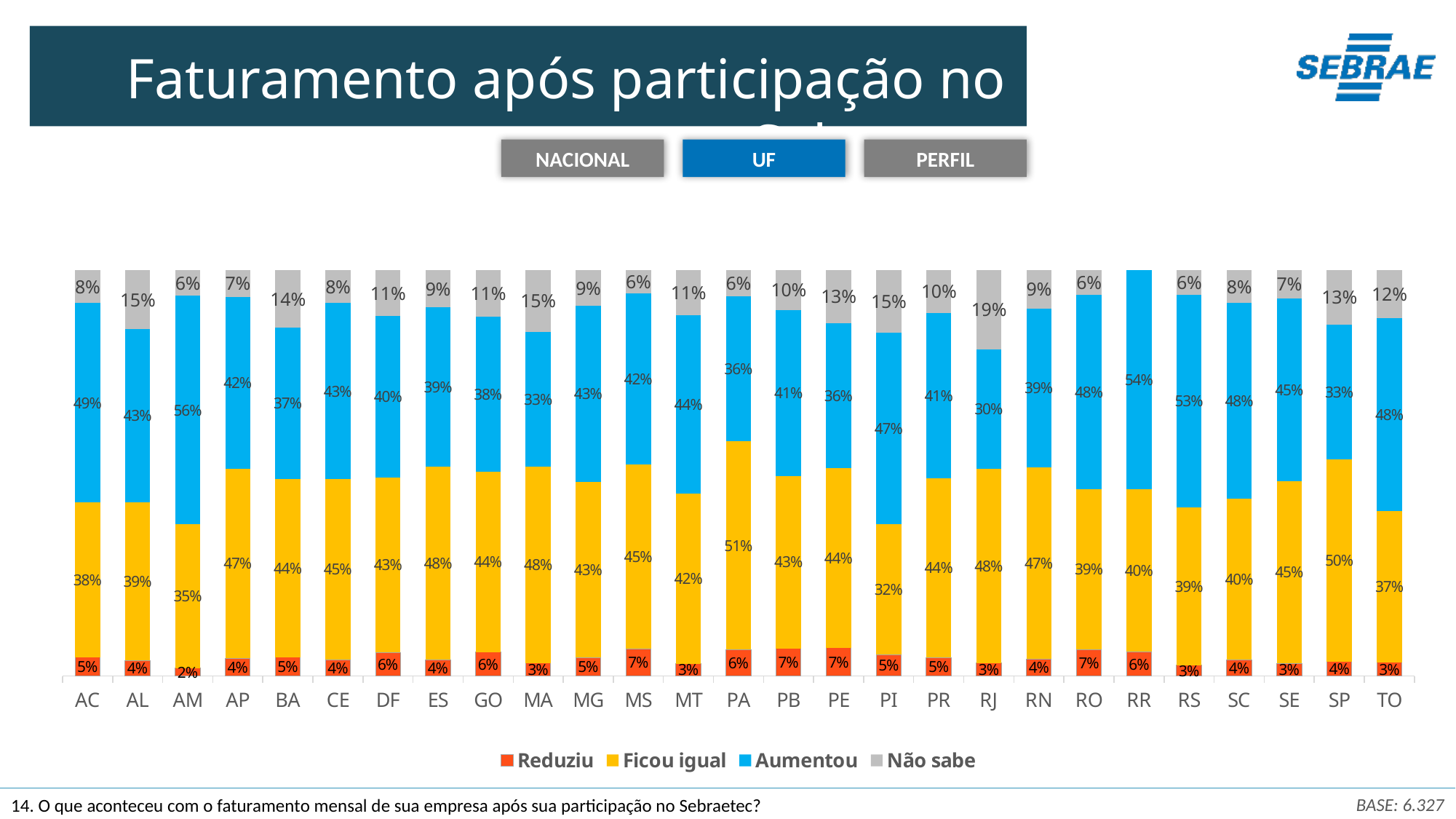
Which legend entry is shown in red? Reduziu Which is larger, the 'Ficou igual' value for SP or for TO? SP What is the difference between the 'Aumentou' values for AM and RJ? 26% Which UF has the lowest 'Reduziu' value? AM Which UF has the highest 'Não sabe' value? RJ What is the 'Ficou igual' value for PA? 51% What is the 'Aumentou' value for AM? 56% What type of chart is shown on the slide? Stacked bar chart How many UF categories are shown on the x axis? 27 What is the 'Não sabe' value for RJ? 19% How many series does the legend list? 4 Which UF has the highest 'Aumentou' value? AM